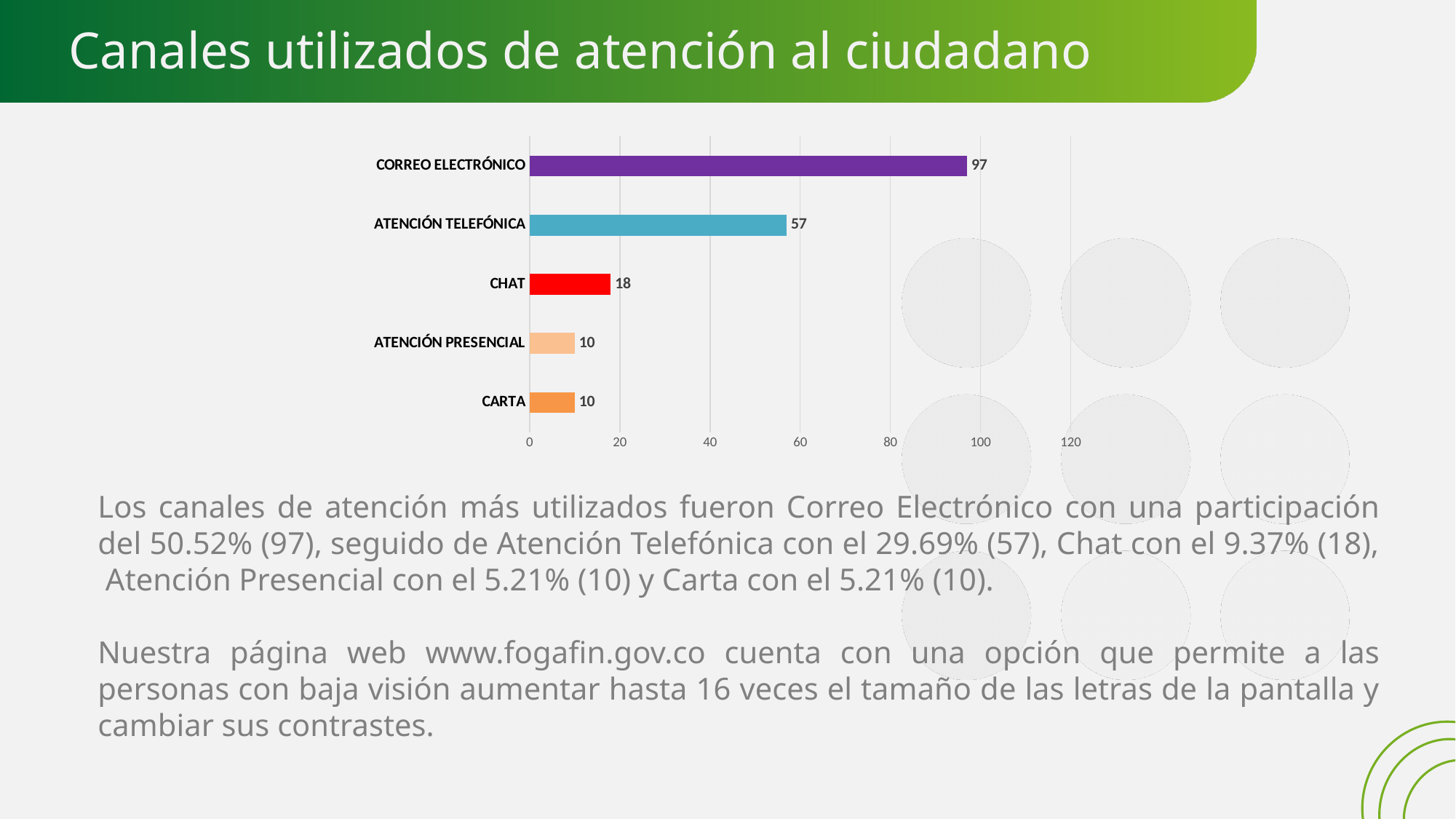
What is the difference between the values for CORREO ELECTRÓNICO and ATENCIÓN TELEFÓNICA? 40 What is the value for ATENCIÓN TELEFÓNICA? 57 Which category has the highest value? CORREO ELECTRÓNICO How many categories are shown in the chart? 5 What is the value for CHAT? 18 What is the difference between the values for ATENCIÓN TELEFÓNICA and CHAT? 39 Is the value for ATENCIÓN TELEFÓNICA greater or less than 60? less What is the value for CARTA? 10 What colour is the bar for CHAT? red What kind of chart is shown on the slide? bar chart What is the value for CORREO ELECTRÓNICO? 97 Which is larger, the value for CHAT or the value for ATENCIÓN PRESENCIAL? CHAT